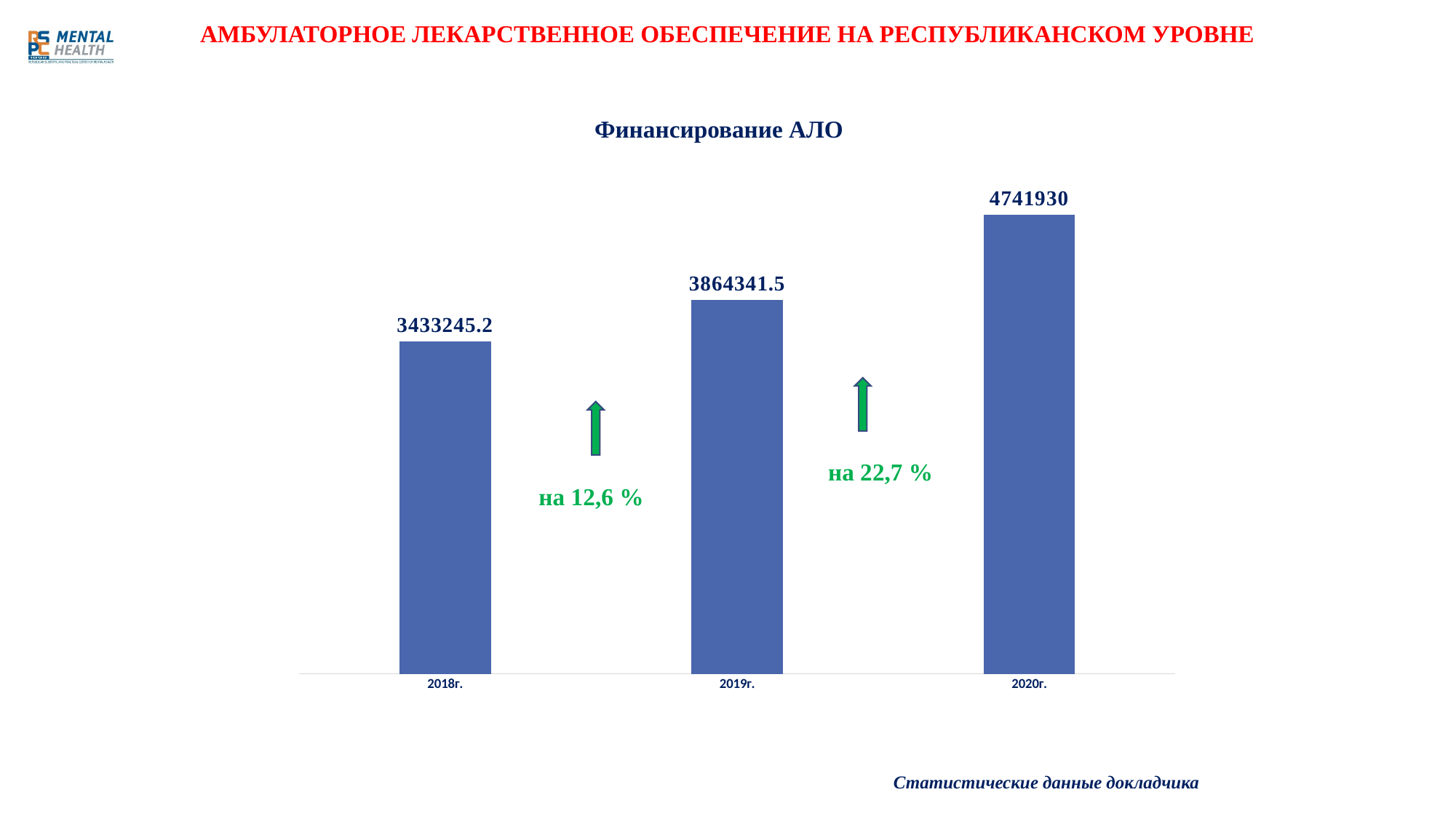
Which year has the lowest value? 2018г. What kind of chart is this? Bar chart What is the difference between the values for 2020г. and 2019г.? 877588.5 How many years are shown on the chart? 3 What is the difference between the values for 2019г. and 2018г.? 431096.3 Which is larger, the value for 2019г. or the value for 2020г.? 2020г. What is the title of the chart? Финансирование АЛО What is the value for 2020г.? 4741930 Which year has the highest value? 2020г. Do the values rise or fall from 2018г. to 2020г.? Rise What is the value for 2019г.? 3864341.5 What is the value for 2018г.? 3433245.2